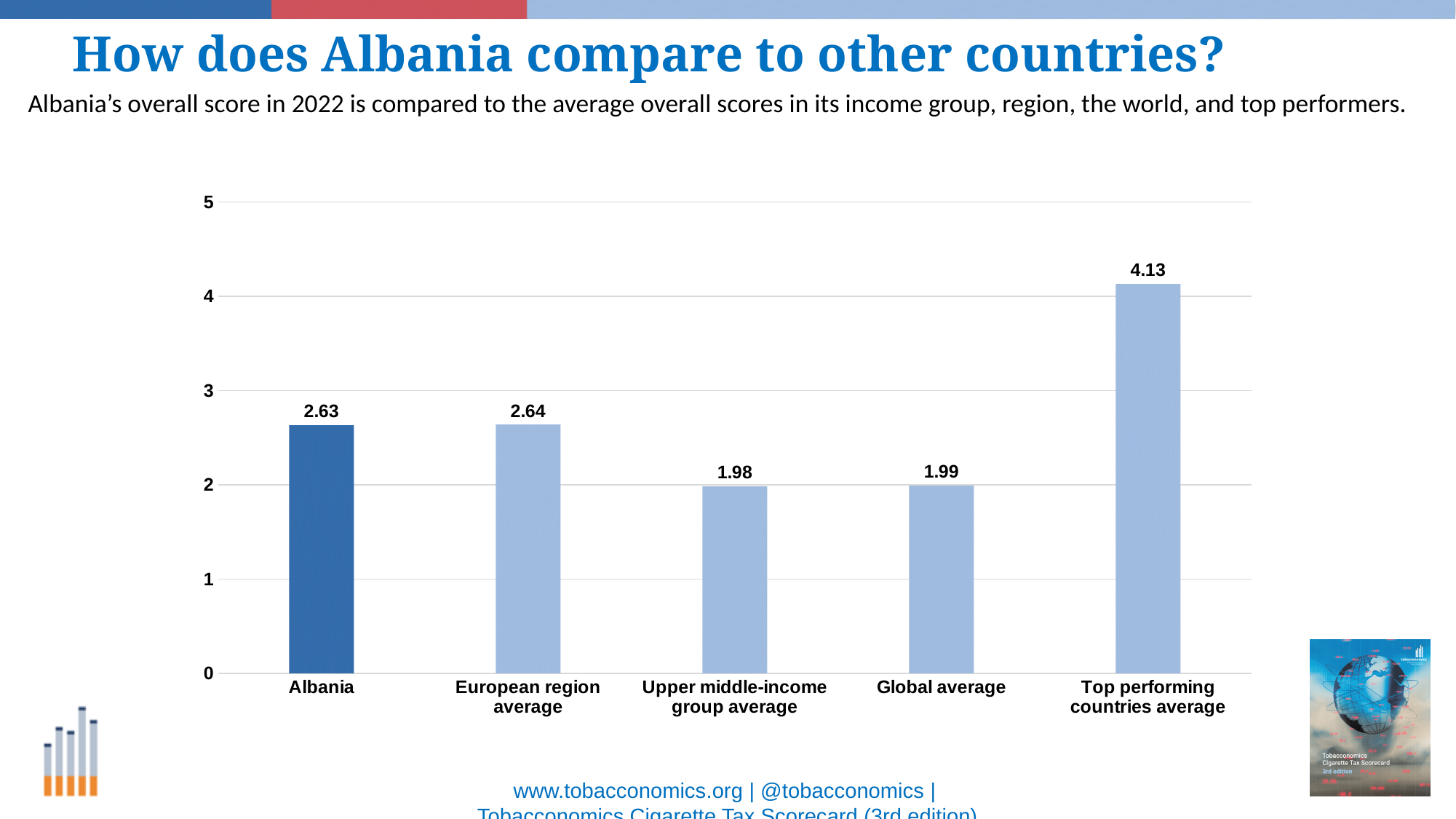
Is the value for the Top performing countries average greater or less than 4? greater What is the difference between Albania and the Global average? 0.64 What kind of chart is shown on the slide? Bar chart What is the value for Albania? 2.63 Which is larger, the value for Albania or the value for the Upper middle-income group average? Albania What is the value for the Upper middle-income group average? 1.98 What is the difference between the Top performing countries average and Albania? 1.50 What is the value for the Top performing countries average? 4.13 How many categories are shown in the chart? 5 What is the value for the Global average? 1.99 What is the value for the European region average? 2.64 Which category has the highest value? Top performing countries average